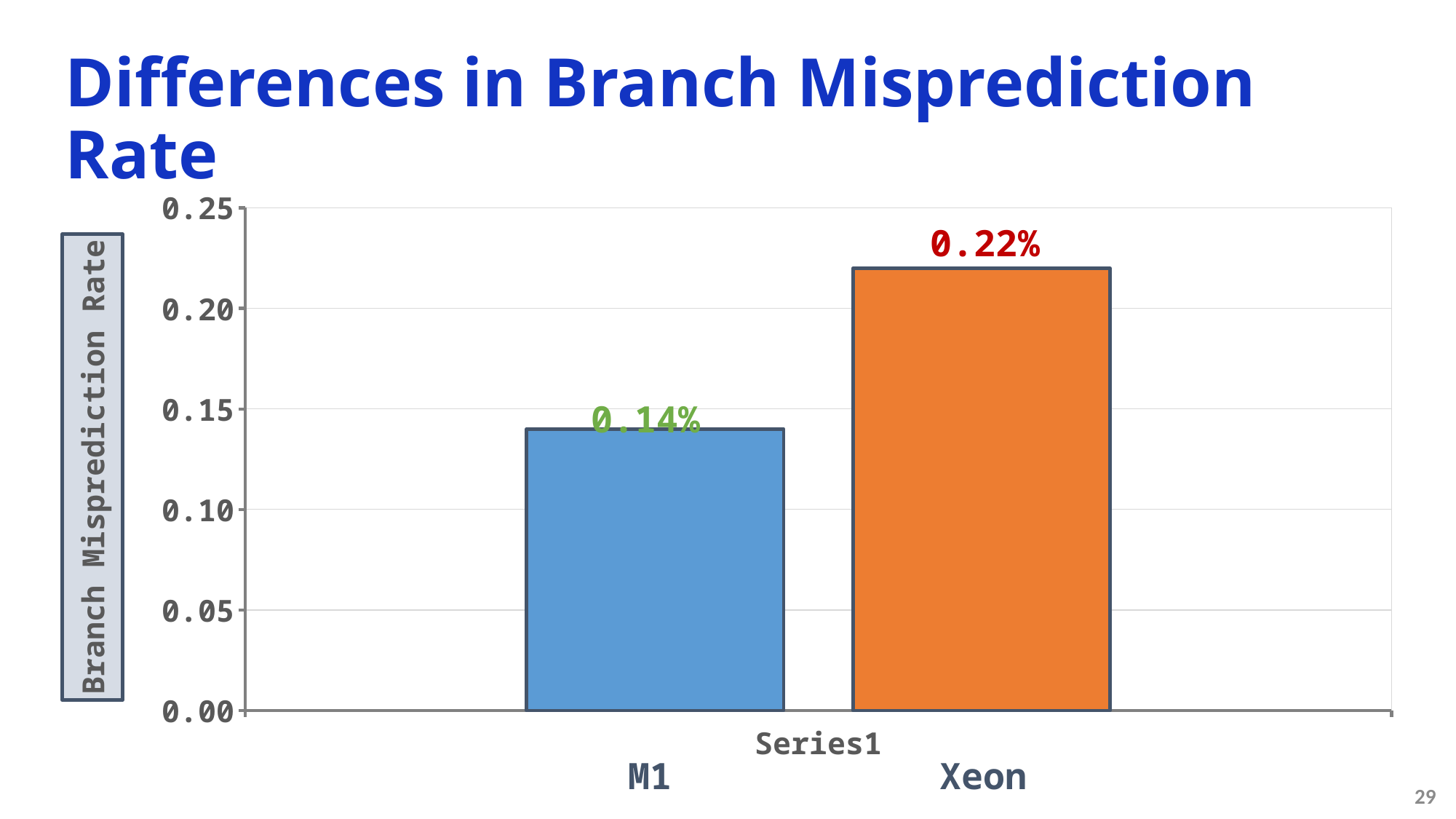
Is the value for M1 greater or less than 0.15? less How many bars are shown in the chart? 2 Which processor has the lower branch misprediction rate? M1 What is the difference between the Xeon and M1 branch misprediction rates? 0.08% What is the label on the vertical axis of the chart? Branch Misprediction Rate What kind of chart is shown on the slide? Bar chart Which processor has the higher branch misprediction rate? Xeon What colour is the bar for Xeon? Orange What is the branch misprediction rate for Xeon? 0.22% Is the value for Xeon greater or less than 0.20? greater Is the branch misprediction rate larger for M1 or for Xeon? Xeon What is the branch misprediction rate for M1? 0.14%